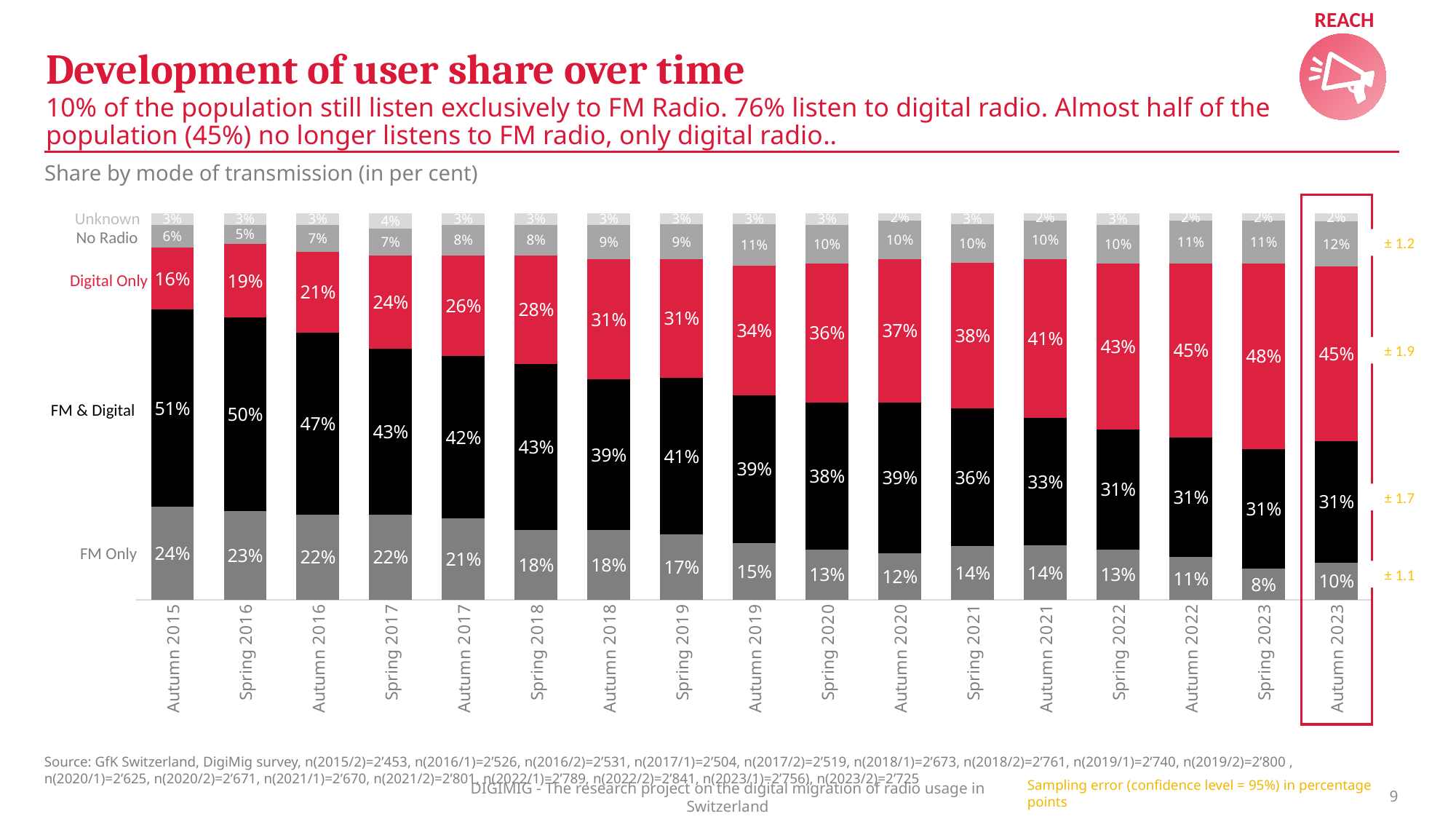
How does the FM Only share change from Autumn 2015 to Autumn 2023? It falls Which is larger in Spring 2019: the FM & Digital share or the Digital Only share? FM & Digital What is the No Radio share in Autumn 2023? 12% What is the FM & Digital share in Autumn 2015? 51% What is the FM Only share in Spring 2023? 8% What kind of chart is shown on the slide? Stacked bar chart What is the combined share of FM Only and FM & Digital in Autumn 2023? 41% How many time periods are shown along the x axis of the chart? 17 What is the difference between the Digital Only share in Autumn 2023 and in Autumn 2015? 29 percentage points In which period is the FM Only share lowest? Spring 2023 In which period is the Digital Only share highest? Spring 2023 What is the Digital Only share in Autumn 2023? 45%